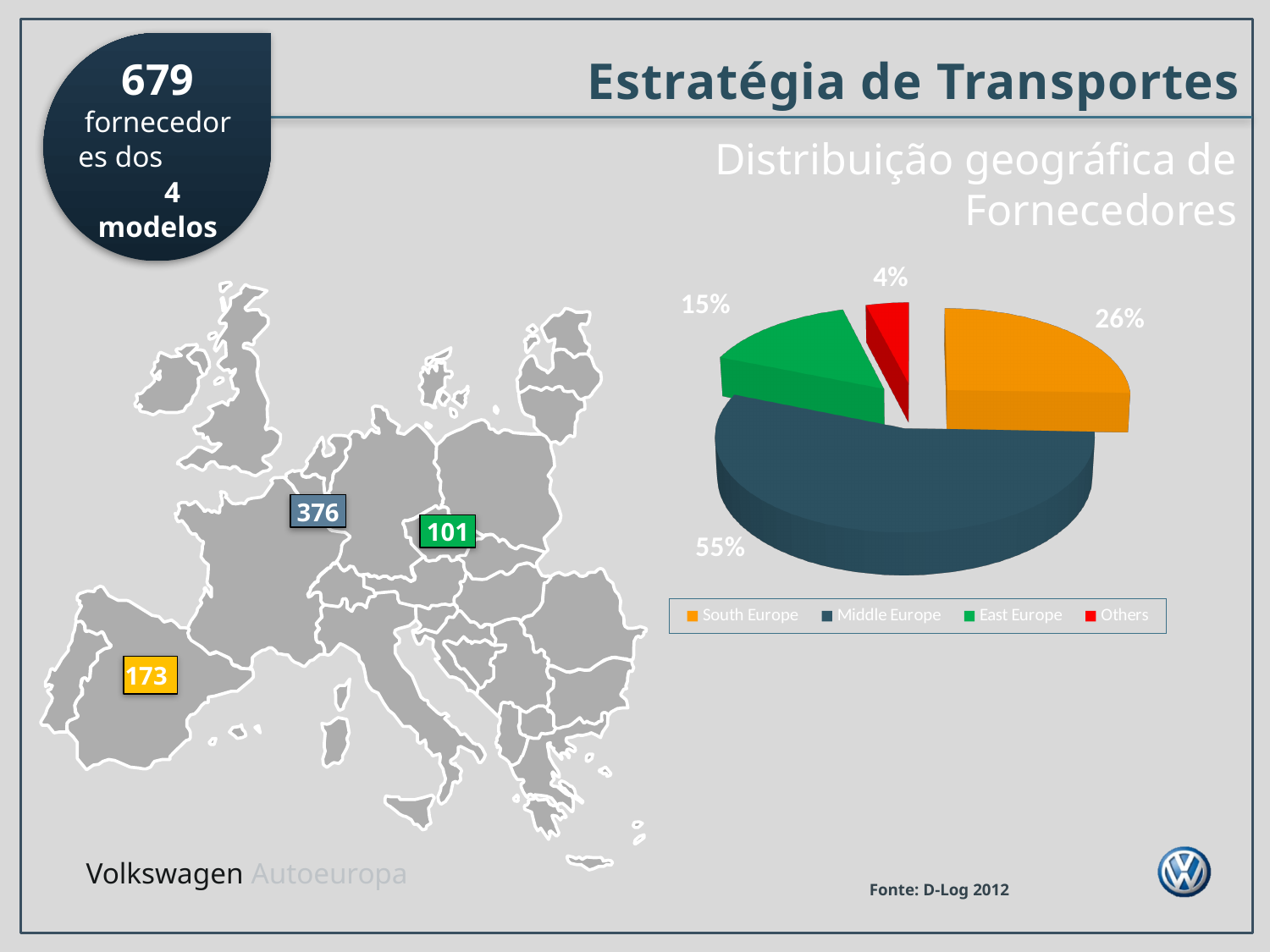
What share of the pie chart does East Europe represent? 15% How many entries does the pie chart legend list? 4 What colour is the Middle Europe slice in the pie chart? Dark blue What share of the pie chart does Middle Europe represent? 55% What kind of chart is shown on the slide? Pie chart What share of the pie chart does Others represent? 4% What is the difference in percentage points between Middle Europe and South Europe in the pie chart? 29 What share of the pie chart does South Europe represent? 26% Which is larger in the pie chart, South Europe or East Europe? South Europe How many slices does the pie chart have? 4 Which category has the largest slice in the pie chart? Middle Europe Which category has the smallest slice in the pie chart? Others